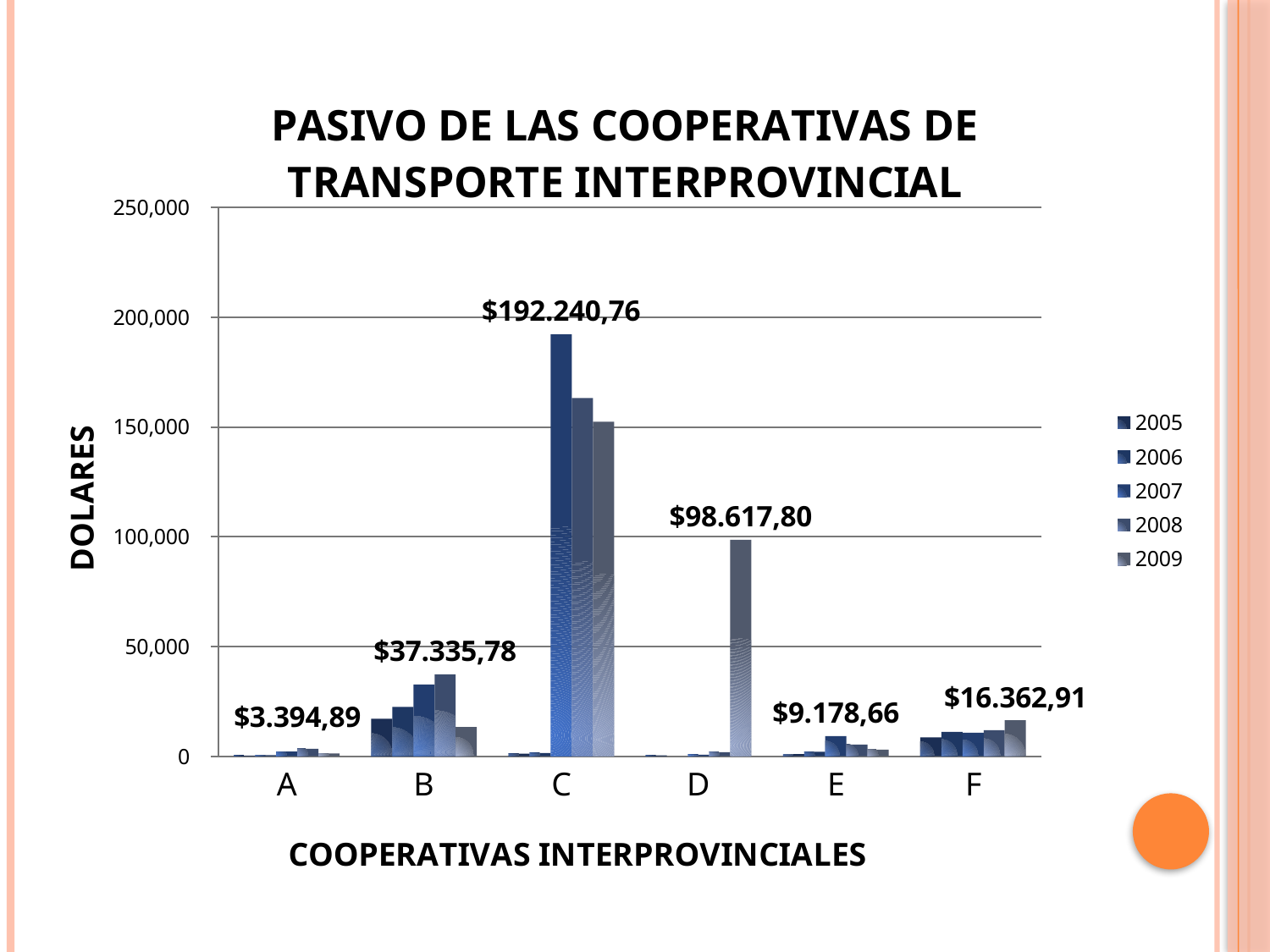
Which cooperative has the lowest labelled value? A What value is labelled for cooperative C? $192.240,76 Is the value for cooperative C in 2008 greater or less than 150,000? greater How many years does the legend list? 5 What is the title of the chart? PASIVO DE LAS COOPERATIVAS DE TRANSPORTE INTERPROVINCIAL What value is labelled for cooperative D? $98.617,80 Which labelled value is larger, cooperative B or cooperative D? D What is the difference between the labelled values for cooperatives C and D? $93.622,96 How many cooperatives are shown on the x axis? 6 What value is labelled for cooperative F? $16.362,91 Which cooperative has the highest labelled value? C What type of chart is shown on the slide? Bar chart